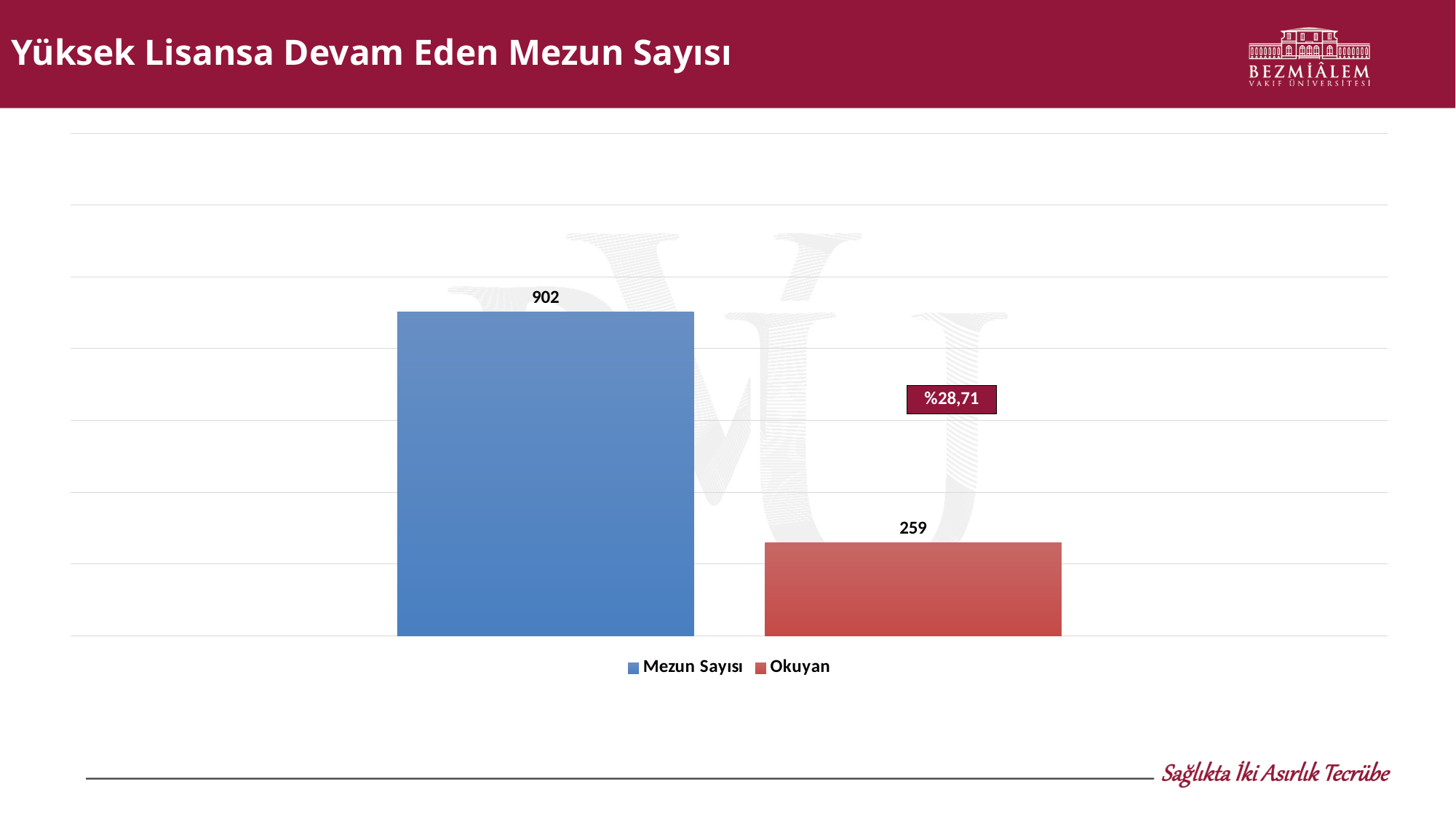
Which series has the higher value, Mezun Sayısı or Okuyan? Mezun Sayısı What is the value for Okuyan? 259 How many series does the legend list? 2 What percentage is shown in the highlighted box on the chart? %28,71 Which bar is the highest? Mezun Sayısı What is the title of the slide? Yüksek Lisansa Devam Eden Mezun Sayısı What kind of chart is shown on the slide? Bar chart What is the difference between the Mezun Sayısı value and the Okuyan value? 643 Which bar is the lowest? Okuyan How many bars are plotted on the chart? 2 What is the value for Mezun Sayısı? 902